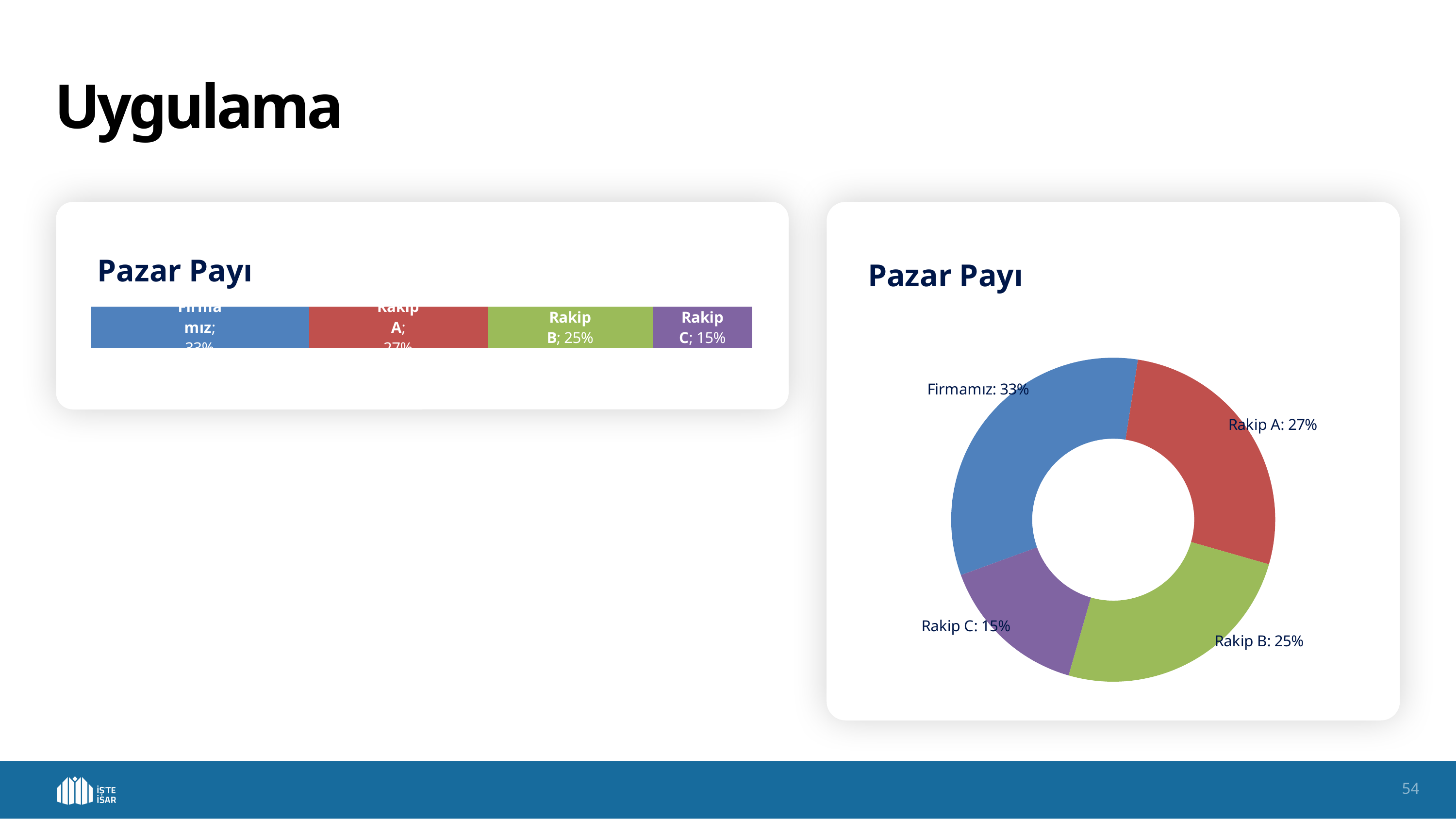
In the doughnut chart on the right, which is larger: Rakip A or Rakip B? Rakip A In the doughnut chart on the right, which category has the largest share? Firmamız How many categories are shown in the doughnut chart on the right? 4 What type of chart is shown on the left side of the slide? bar chart What type of chart is shown on the right side of the slide? doughnut chart In the doughnut chart on the right, what is the share for Rakip A? 27% In the doughnut chart on the right, what is the difference between the shares of Firmamız and Rakip C? 18% In the bar chart on the left, what is the value for Rakip B? 25% In the bar chart on the left, what is the value for Rakip C? 15% In the doughnut chart on the right, which category has the smallest share? Rakip C What is the title of the doughnut chart on the right? Pazar Payı In the doughnut chart on the right, what is the share for Firmamız? 33%